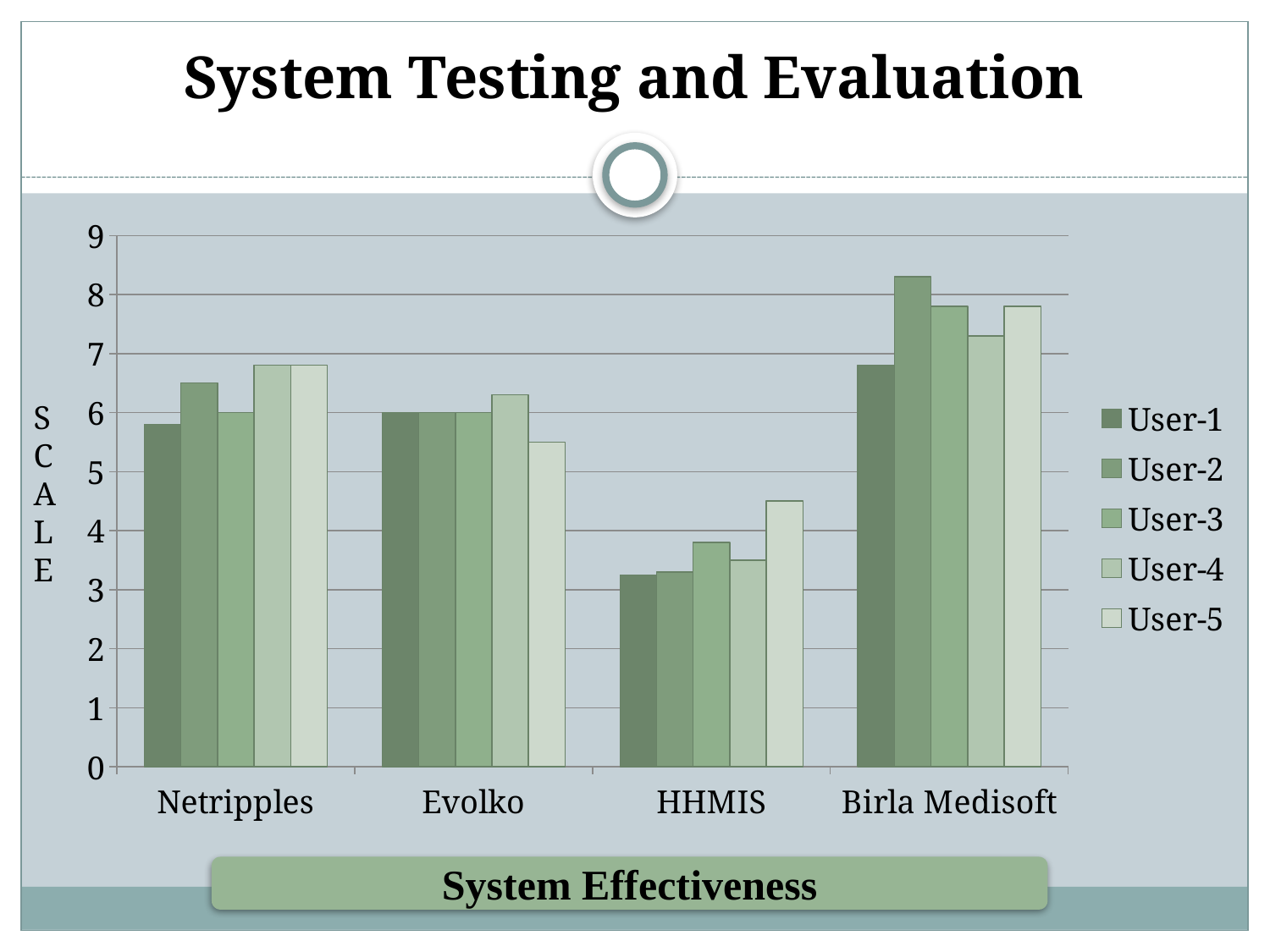
How many systems (categories) are shown on the x axis? 4 Which system has the highest User-2 value? Birla Medisoft Is the User-2 value for Birla Medisoft greater or less than 8? greater Is the User-4 value for Netripples greater or less than 6? greater What label is shown beneath the x axis of the chart? System Effectiveness Which is larger: the User-2 value for Netripples or the User-2 value for Evolko? Netripples Is the User-1 value for HHMIS greater or less than 4? less How many series does the legend list? 5 What kind of chart is shown on the slide? bar chart Which is larger: the User-5 value for HHMIS or the User-5 value for Birla Medisoft? Birla Medisoft What is the User-1 value for Evolko? 6 Which system has the lowest User-1 value? HHMIS